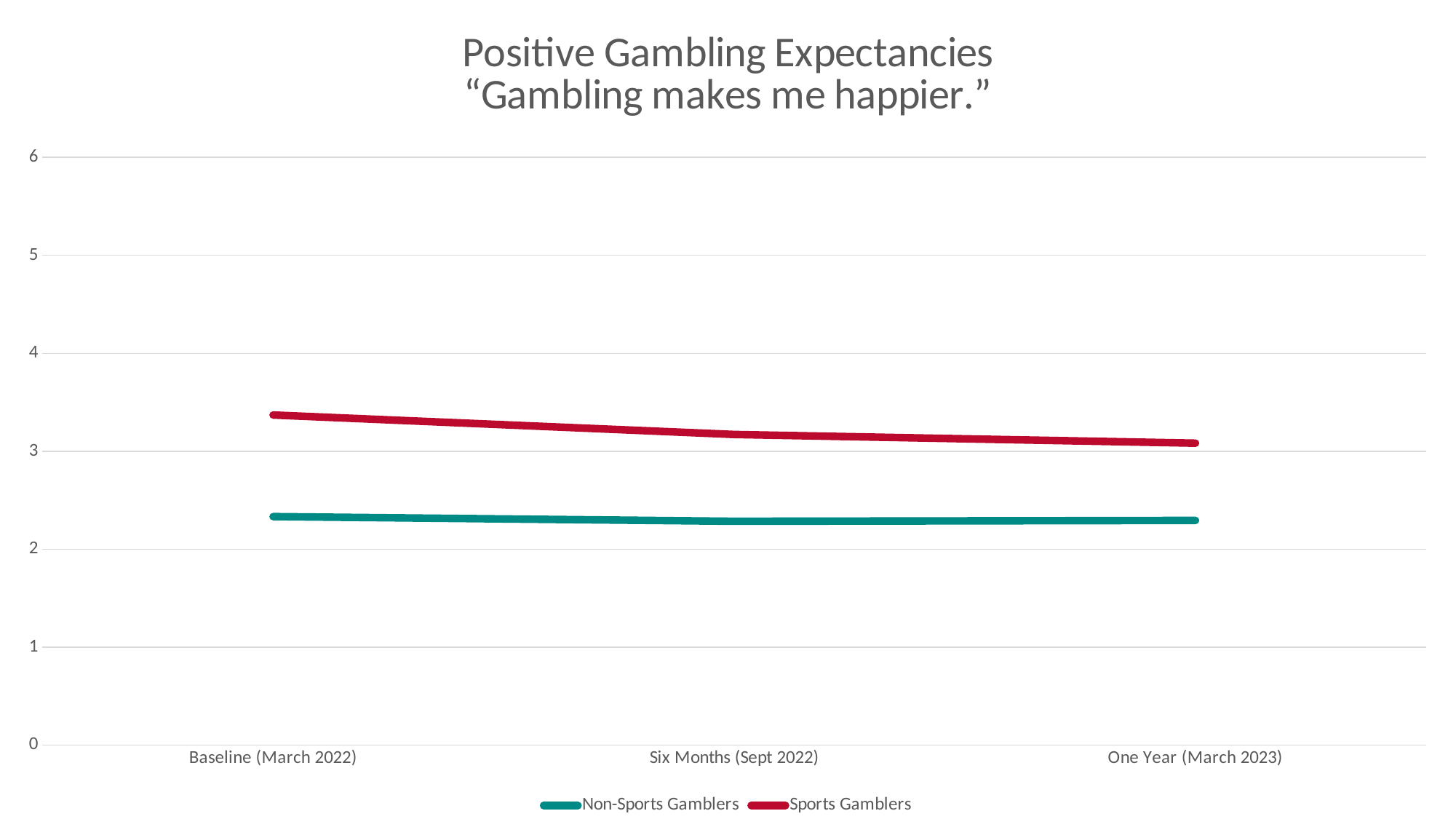
What is the title of the chart? Positive Gambling Expectancies “Gambling makes me happier.” What colour is the Sports Gamblers line? red Does the Sports Gamblers line rise or fall from Baseline (March 2022) to One Year (March 2023)? fall How many series does the legend list? 2 Is the value for Non-Sports Gamblers at Baseline (March 2022) greater or less than 2? greater How many time points are shown on the x axis? 3 Is the value for Sports Gamblers at One Year (March 2023) greater or less than 4? less Is the value for Sports Gamblers at Baseline (March 2022) greater or less than 3? greater Which series has the lower value at One Year (March 2023)? Non-Sports Gamblers What kind of chart is shown on the slide? line chart Which series has the higher value at Baseline (March 2022)? Sports Gamblers